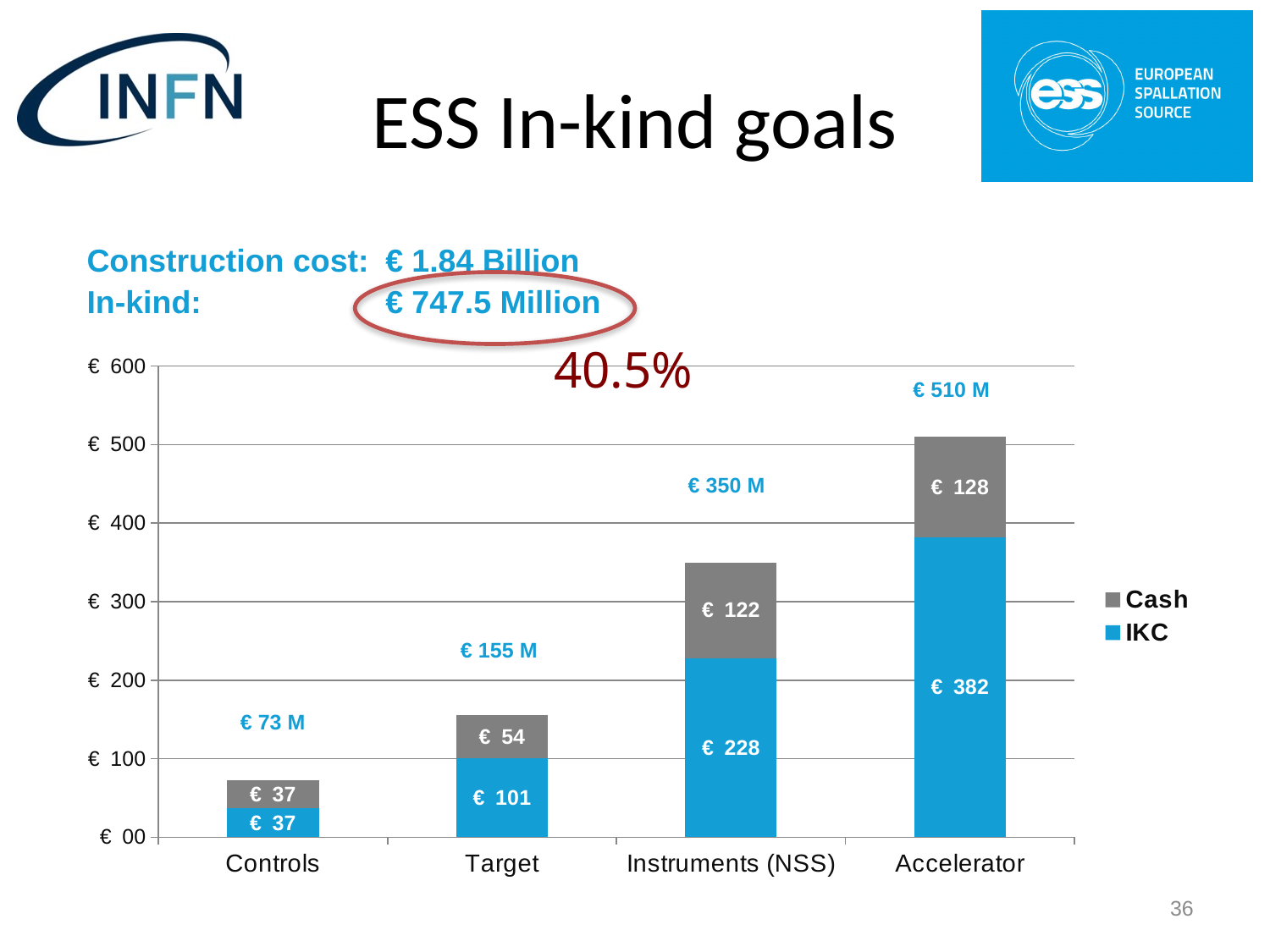
How many series does the legend list? 2 What is the IKC value for Accelerator? € 382 Which category has the lowest total? Controls What kind of chart is shown? Stacked bar chart What is the Cash value for Instruments (NSS)? € 122 What is the total labelled above the Target bar? € 155 M Do the bar totals rise or fall from Controls to Accelerator? Rise Which colour represents the Cash series in the legend? Grey What is the difference between the IKC values for Accelerator and Instruments (NSS)? € 154 How many categories are shown on the x axis? 4 Which category has the highest total? Accelerator Which is larger, the Cash value for Target or the Cash value for Controls? Target